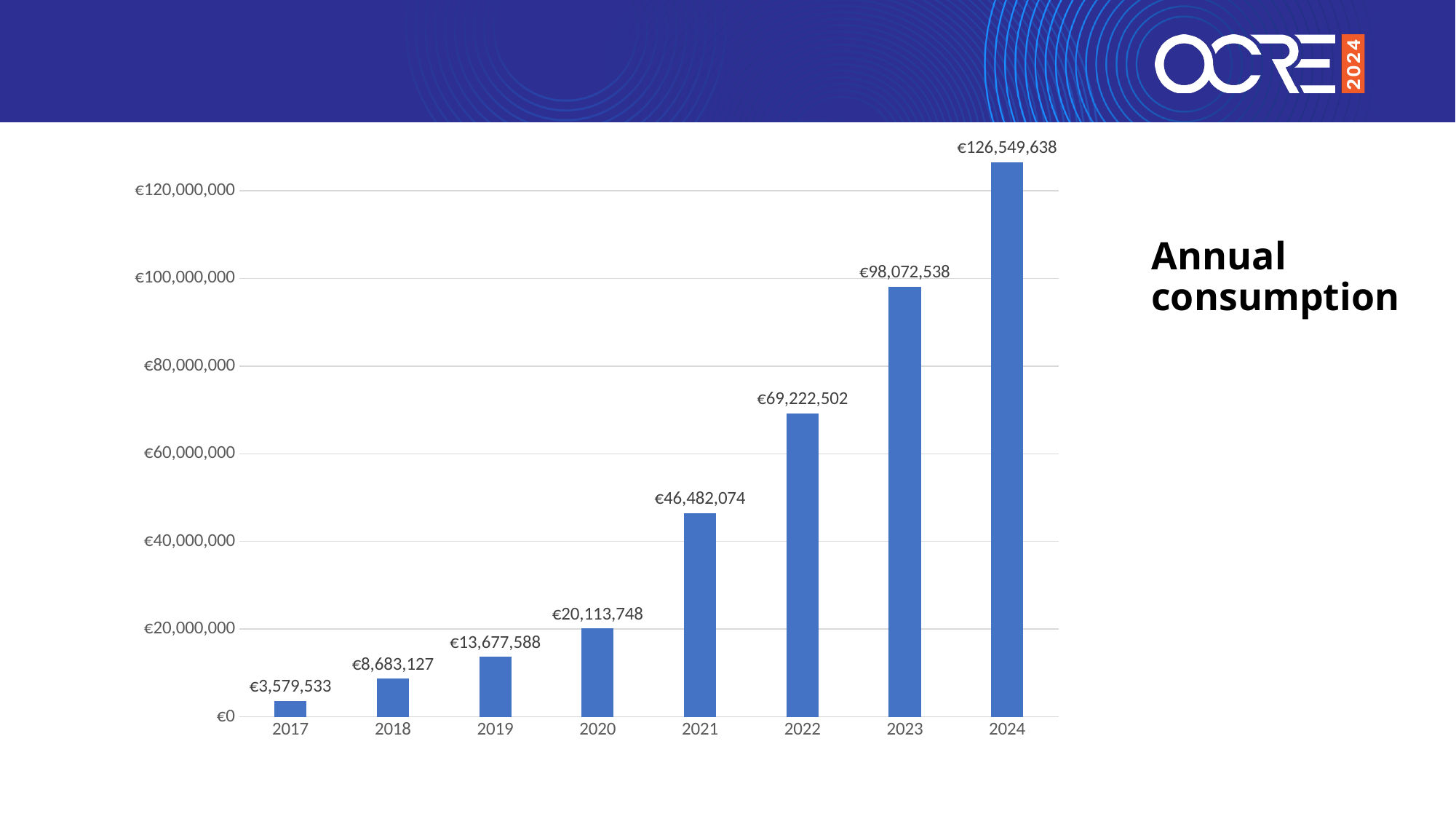
Which year has the highest annual consumption? 2024 Which year has the lowest annual consumption? 2017 What is the difference between the annual consumption in 2024 and in 2023? €28,477,100 How many years are shown on the x axis of the chart? 8 What is the annual consumption value shown for 2017? €3,579,533 Which year has the larger annual consumption, 2020 or 2022? 2022 Do the annual consumption values rise or fall from 2017 to 2024? rise What is the difference between the annual consumption in 2018 and in 2017? €5,103,594 What is the annual consumption value shown for 2024? €126,549,638 Is the annual consumption for 2023 greater or less than €100,000,000? less What kind of chart is used to show annual consumption? bar chart What is the annual consumption value shown for 2021? €46,482,074